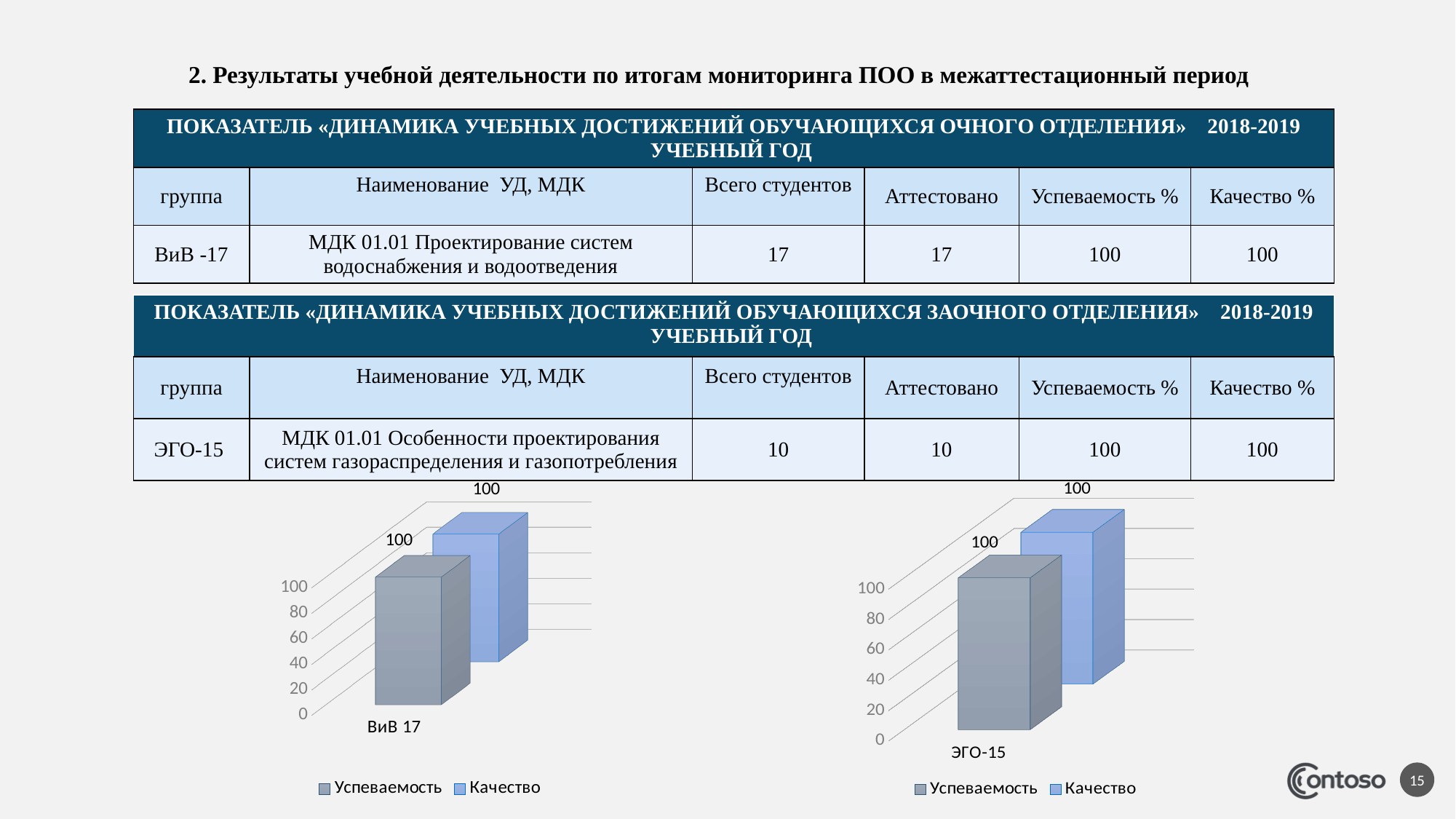
In the left chart, what is the value of Качество for ВиВ 17? 100 In the right chart, what is the difference between the Успеваемость and Качество values for ЭГО-15? 0 In the right chart, is the value of Качество for ЭГО-15 greater or less than 80? greater In the right chart, what is the value of Успеваемость for ЭГО-15? 100 How many series does the legend of the left chart list? 2 How many series does the legend of the right chart list? 2 In the left chart, what is the value of Успеваемость for ВиВ 17? 100 What category label appears on the x axis of the left chart? ВиВ 17 What kind of chart is the left chart? Bar chart In the left chart, what is the difference between the Успеваемость and Качество values for ВиВ 17? 0 In the right chart, what is the value of Качество for ЭГО-15? 100 How many categories are shown on the x axis of the right chart? 1